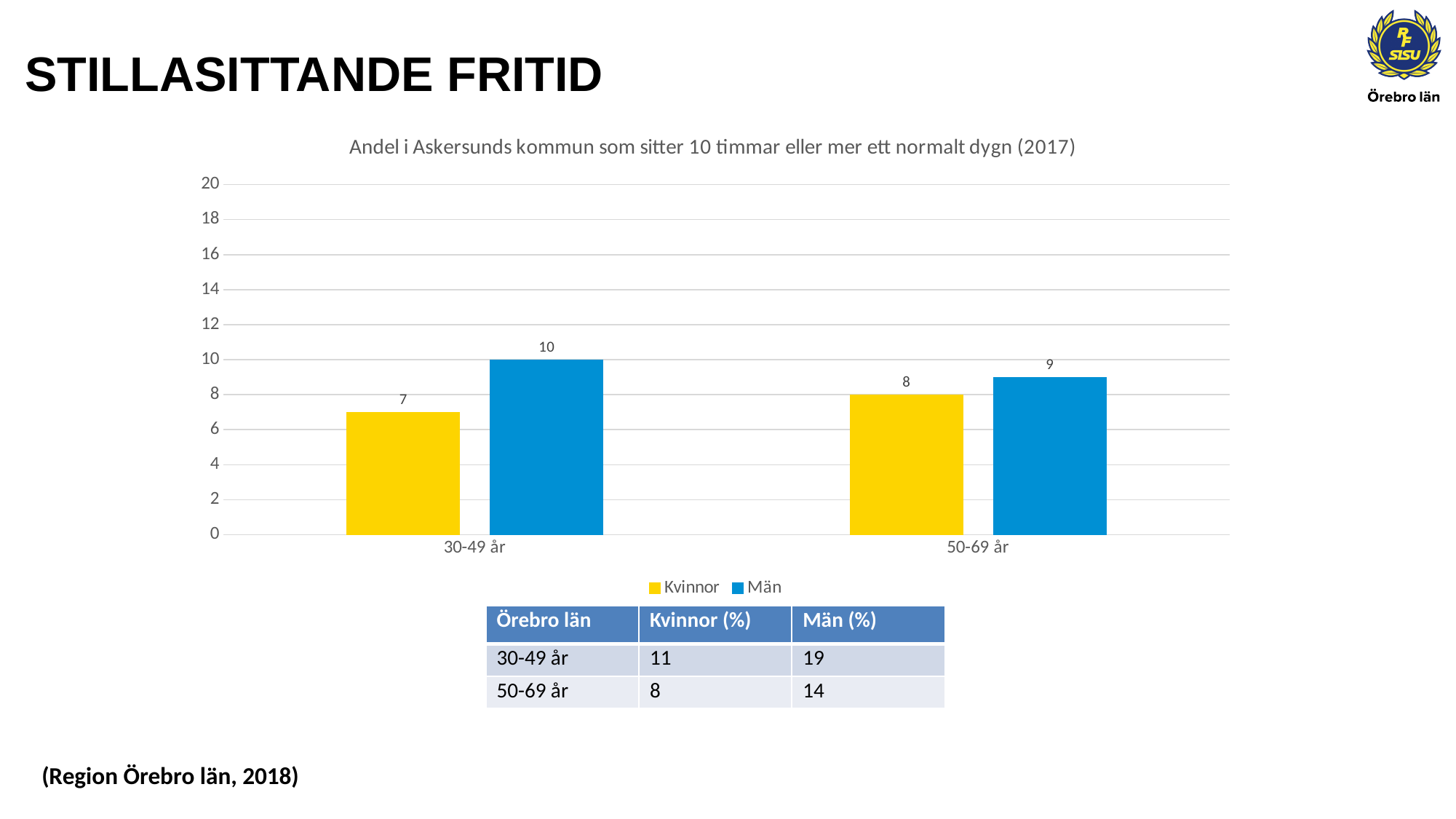
Which bar has the highest value in the chart? Män, 30-49 år How many series does the legend list? 2 What is the value for Män in the 30-49 år group? 10 Which bar has the lowest value in the chart? Kvinnor, 30-49 år What is the value for Kvinnor in the 50-69 år group? 8 How many age groups are shown on the x axis? 2 Which is larger in the 50-69 år group, Kvinnor or Män? Män Which colour represents Kvinnor in the chart? Yellow What is the difference between Män and Kvinnor in the 30-49 år group? 3 What is the value for Män in the 50-69 år group? 9 What kind of chart is shown on the slide? Bar chart What is the value for Kvinnor in the 30-49 år group? 7